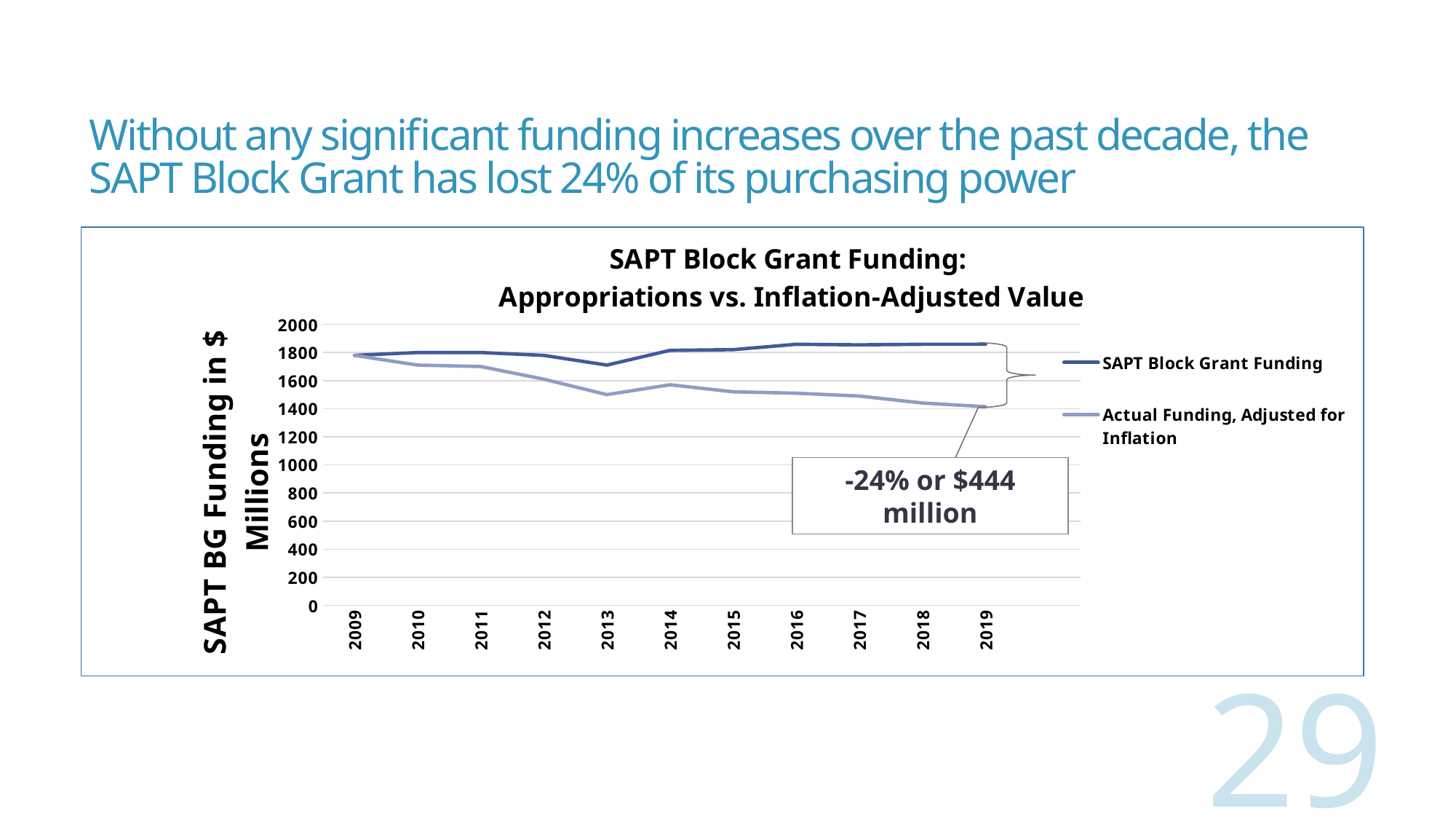
Is the value for Actual Funding, Adjusted for Inflation in 2013 greater or less than 1600? less What kind of chart is shown on the slide? line chart Does the Actual Funding, Adjusted for Inflation line rise or fall from 2009 to 2019? fall How many series does the legend of the chart list? 2 How many years are shown along the x axis of the chart? 11 What does the callout box on the chart say about the gap between the two lines in 2019? -24% or $444 million Is the value for SAPT Block Grant Funding in 2019 greater or less than 1800? greater Is the value for Actual Funding, Adjusted for Inflation in 2019 greater or less than 1600? less In which year is the SAPT Block Grant Funding line at its lowest? 2013 What is the title of the chart? SAPT Block Grant Funding: Appropriations vs. Inflation-Adjusted Value In which year is the Actual Funding, Adjusted for Inflation line at its lowest? 2019 In 2019, which series has the higher value: SAPT Block Grant Funding or Actual Funding, Adjusted for Inflation? SAPT Block Grant Funding